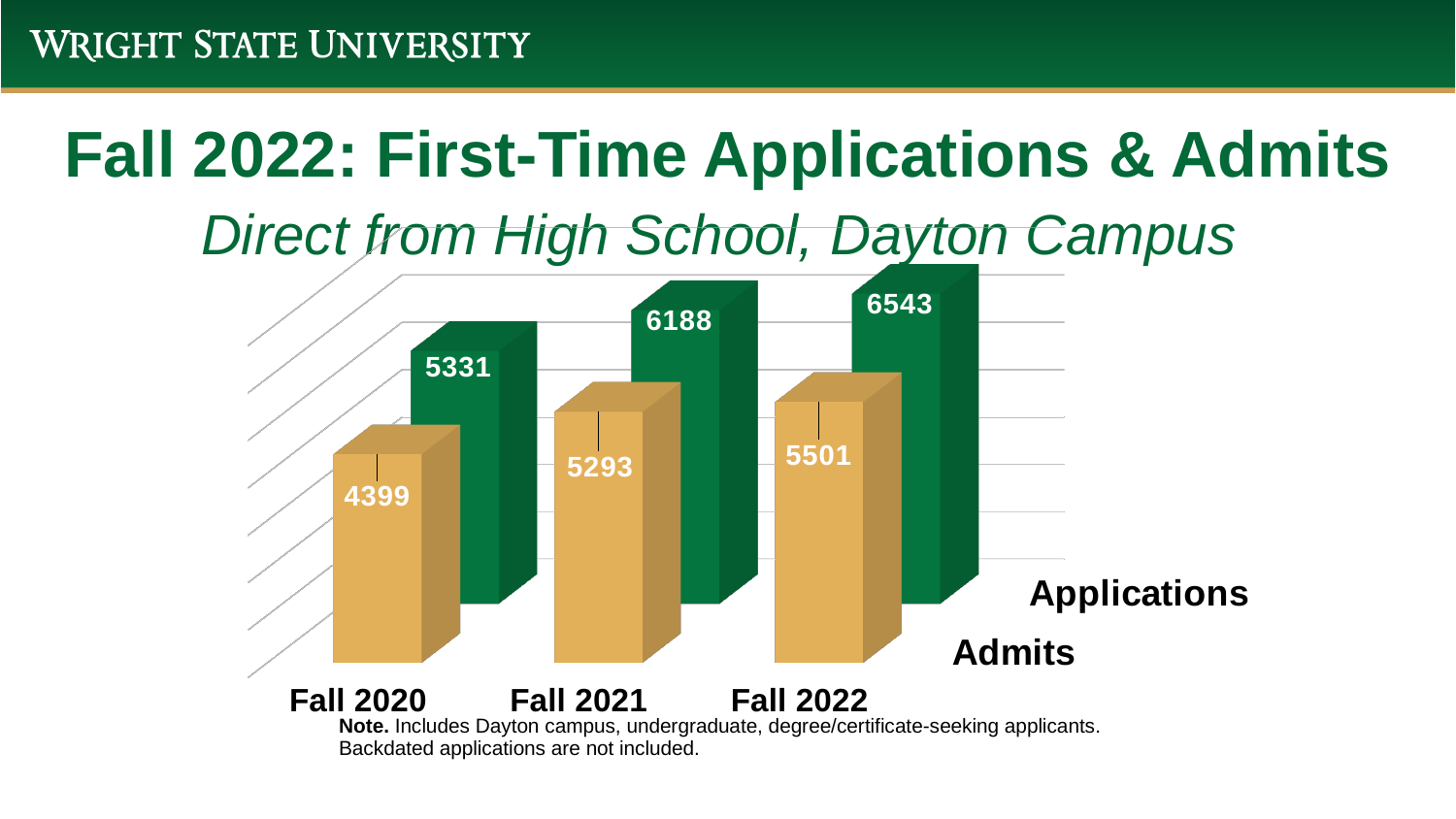
How many terms are shown on the x axis? 3 Which is larger: Admits in Fall 2021 or Admits in Fall 2022? Admits in Fall 2022 What is the number of Admits for Fall 2022? 5501 Do Admits rise or fall from Fall 2020 to Fall 2022? rise How many series does the chart show? 2 Which term has the lowest number of Admits? Fall 2020 What is the number of Applications for Fall 2021? 6188 What is the difference between Applications and Admits in Fall 2022? 1042 Which term has the highest number of Applications? Fall 2022 What is the number of Admits for Fall 2020? 4399 What is the number of Applications for Fall 2022? 6543 By how much did Applications increase from Fall 2020 to Fall 2021? 857